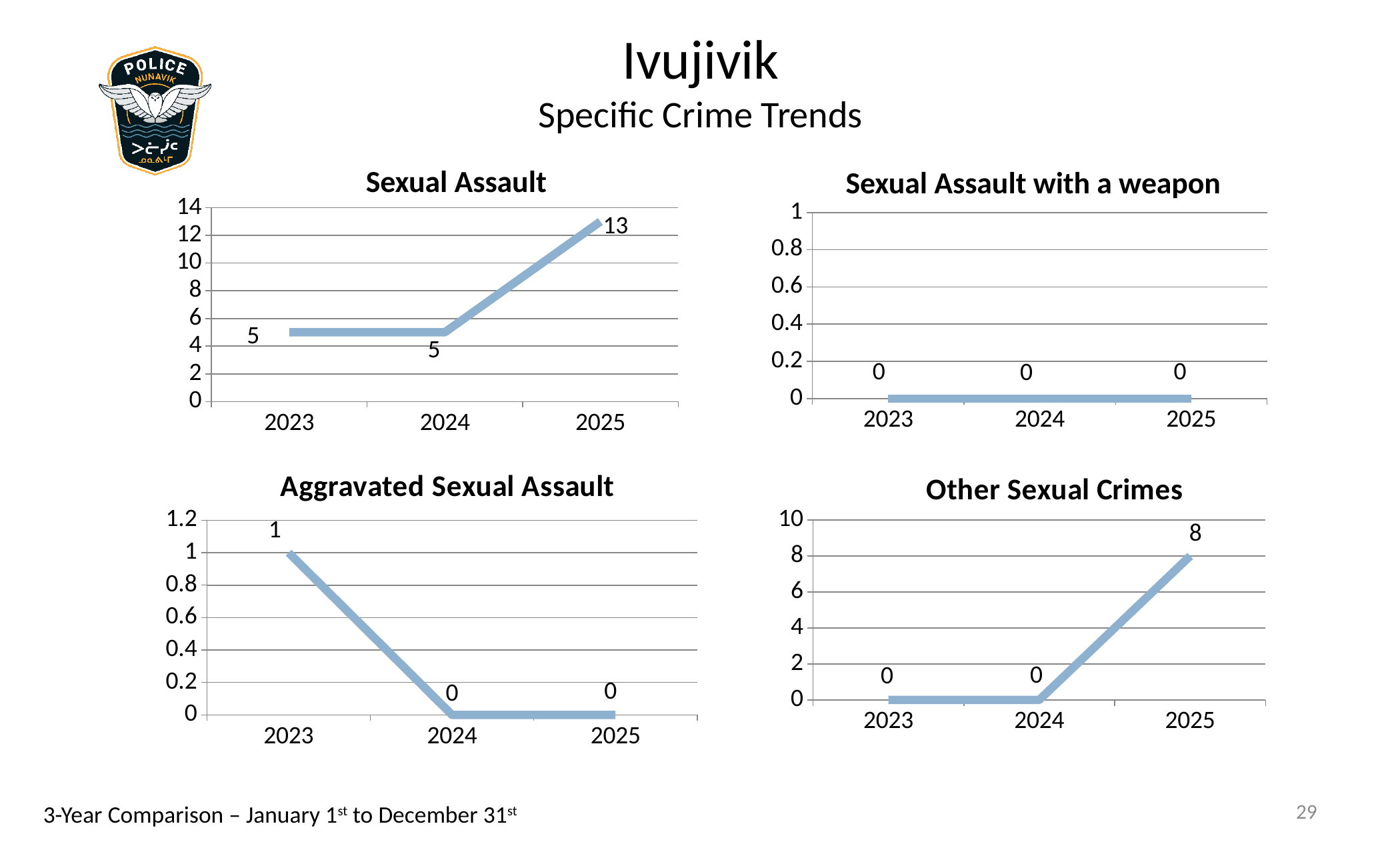
In the Aggravated Sexual Assault chart, which year has the highest value? 2023 What kind of chart is the Sexual Assault chart? line chart In the Sexual Assault chart, what is the difference between the 2025 and 2024 values? 8 In the Sexual Assault with a weapon chart, what is the value for 2024? 0 In the Other Sexual Crimes chart, is the value for 2025 greater than or less than the value for 2024? greater In the Sexual Assault chart, what is the value for 2025? 13 In the Sexual Assault chart, what is the value for 2023? 5 In the Other Sexual Crimes chart, what is the value for 2025? 8 In the Sexual Assault chart, which year has the highest value? 2025 In the Aggravated Sexual Assault chart, what is the value for 2023? 1 In the Aggravated Sexual Assault chart, do values rise or fall from 2023 to 2024? fall How many years are plotted in the Other Sexual Crimes chart? 3